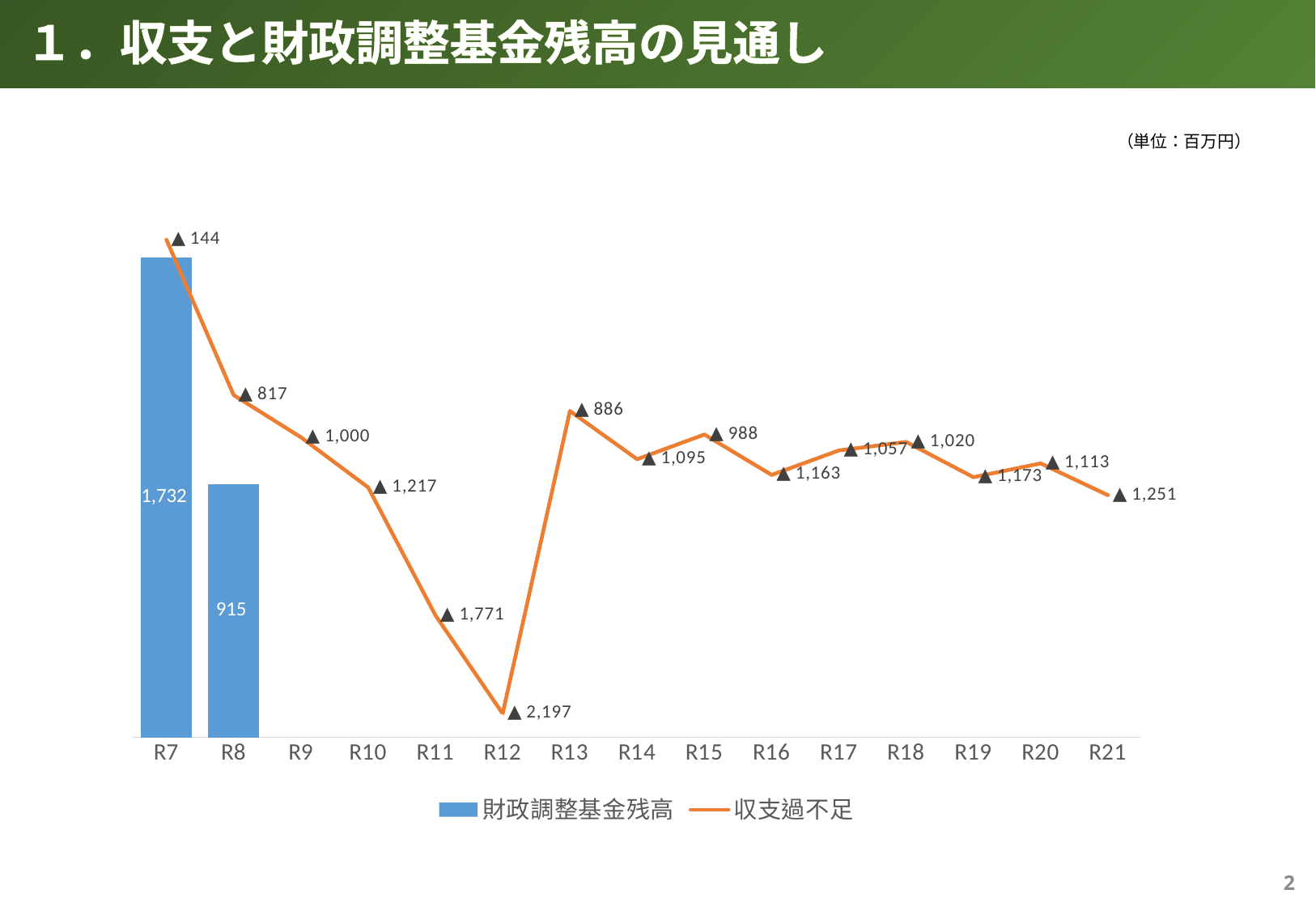
How many series does the legend list? 2 What unit is stated for the chart values? 百万円 What is the value of 財政調整基金残高 for R8? 915 What is the 収支過不足 value shown for R7? ▲ 144 What is the value of 財政調整基金残高 for R7? 1,732 Which is larger, the 財政調整基金残高 bar for R7 or for R8? R7 What is the 収支過不足 value shown for R12? ▲ 2,197 What is the difference between the 財政調整基金残高 values for R7 and R8? 817 Which year has the lowest point on the 収支過不足 line? R12 How many years are shown on the x axis? 15 What is the 収支過不足 value shown for R21? ▲ 1,251 What kind of chart is shown on the slide? Combined bar and line chart